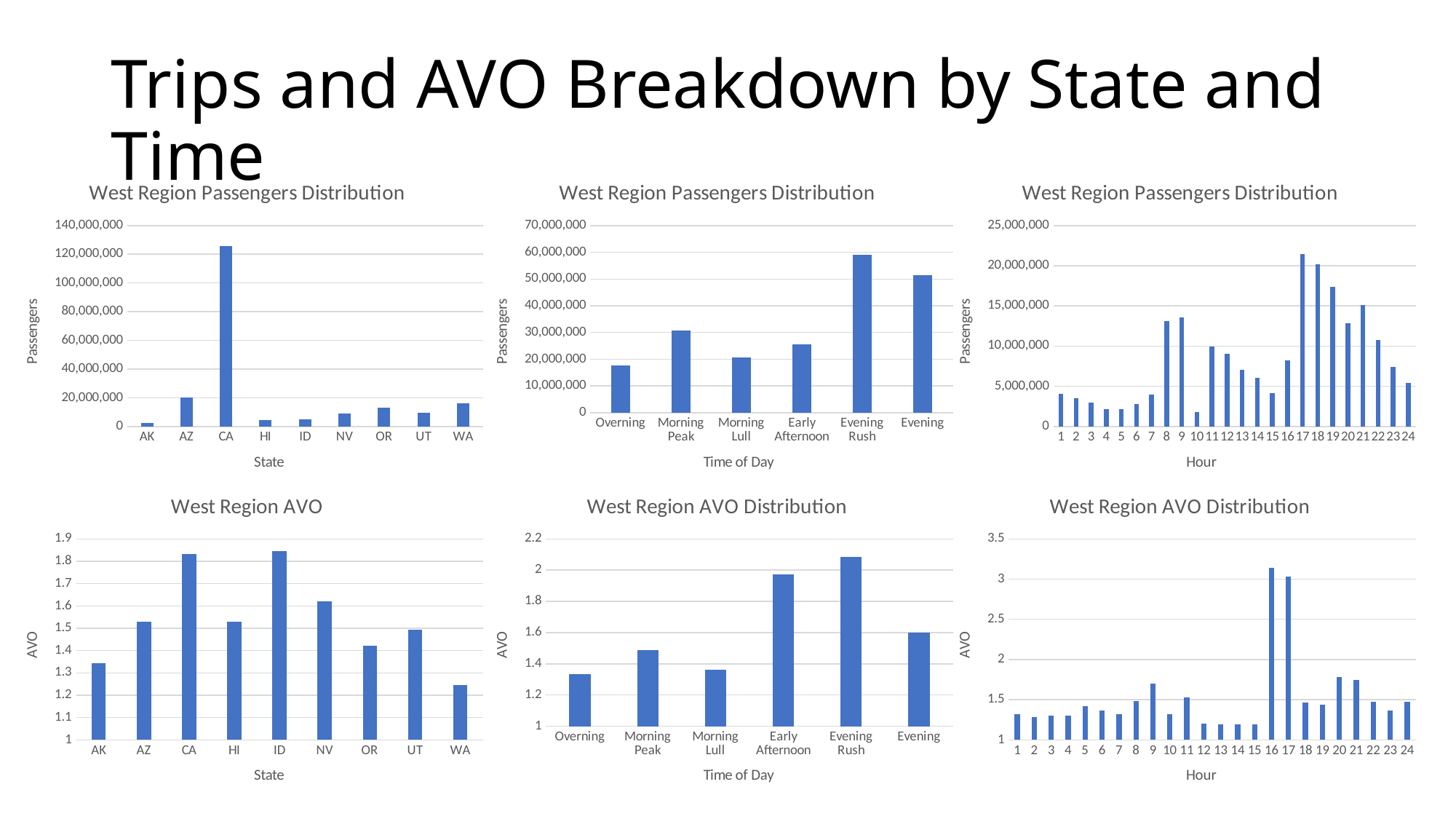
In the bottom-middle chart (West Region AVO Distribution by Time of Day), is the value for Early Afternoon greater or less than 1.8? greater What kind of chart is the bottom-right chart (West Region AVO Distribution by Hour)? bar chart In the top-middle chart (West Region Passengers Distribution by Time of Day), is the value for Evening Rush greater or less than 50,000,000? greater How many states are shown on the x axis of the top-left chart (West Region Passengers Distribution by State)? 9 In the top-middle chart (West Region Passengers Distribution by Time of Day), which time of day has the highest number of passengers? Evening Rush In the top-left chart (West Region Passengers Distribution by State), which state has the highest number of passengers? CA In the bottom-left chart (West Region AVO by State), which state has the lowest AVO? WA In the top-left chart (West Region Passengers Distribution by State), which state has the lowest number of passengers? AK In the top-right chart (West Region Passengers Distribution by Hour), which hour has the highest number of passengers? 17 In the top-left chart (West Region Passengers Distribution by State), is the value for CA greater or less than 100,000,000? greater How many hours are shown on the x axis of the bottom-right chart (West Region AVO Distribution by Hour)? 24 In the top-middle chart (West Region Passengers Distribution by Time of Day), which is larger, Morning Peak or Early Afternoon? Morning Peak